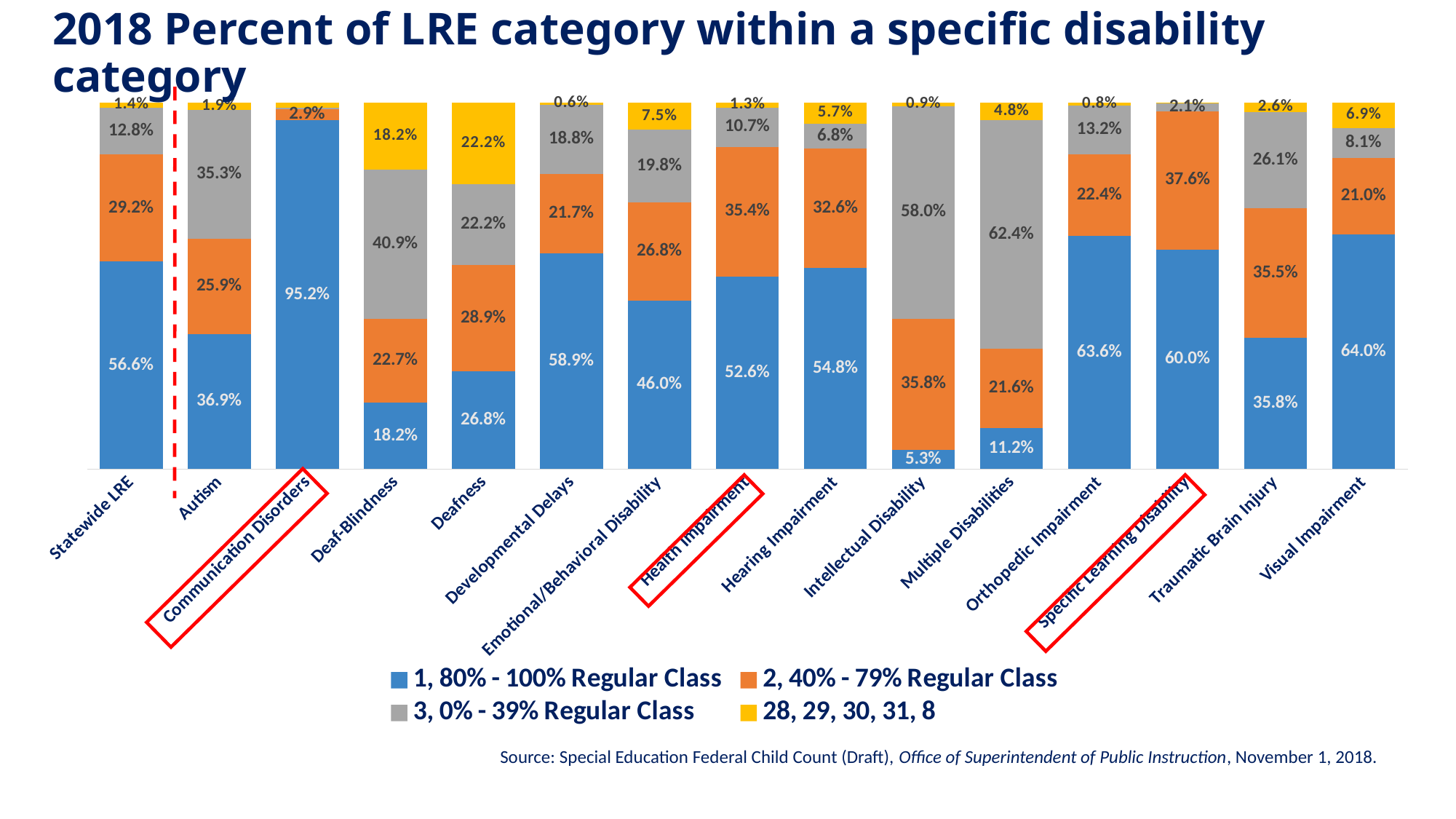
What is the value of the "28, 29, 30, 31, 8" series for Deafness? 22.2% How many disability categories are shown on the x axis? 15 What is the value of the "3, 0% - 39% Regular Class" series for Multiple Disabilities? 62.4% What kind of chart is shown on the slide? Stacked bar chart What is the difference between the "1, 80% - 100% Regular Class" values for Visual Impairment and Traumatic Brain Injury? 28.2% Which is larger: the "3, 0% - 39% Regular Class" value for Intellectual Disability or for Autism? Intellectual Disability What is the value of the "2, 40% - 79% Regular Class" series for Specific Learning Disability? 37.6% Which disability category has the highest value for the "1, 80% - 100% Regular Class" series? Communication Disorders How many series does the legend list? 4 Which disability category has the lowest value for the "1, 80% - 100% Regular Class" series? Intellectual Disability What is the value of the "1, 80% - 100% Regular Class" series for Autism? 36.9% What colour represents the "28, 29, 30, 31, 8" series in the legend? Yellow